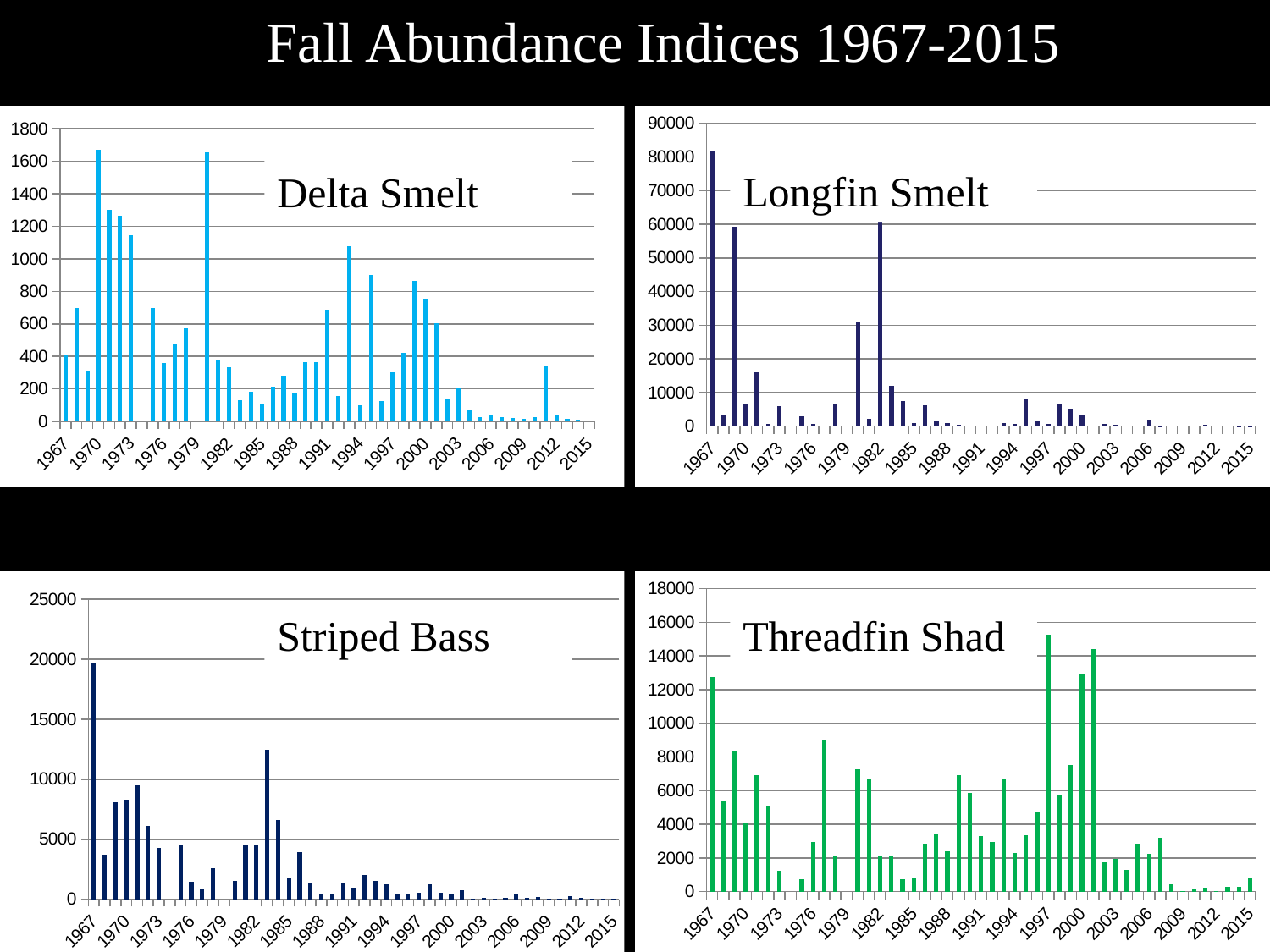
In the Delta Smelt chart, is the value for 1993 greater or less than 1000? greater In the Longfin Smelt chart, which year has the highest value? 1967 In the Striped Bass chart, is the value for 1967 greater or less than 15000? greater What is the title of the slide containing the four charts? Fall Abundance Indices 1967-2015 In the Longfin Smelt chart, is the value for 1967 greater or less than 70000? greater In the Longfin Smelt chart, which is larger, the value for 1967 or the value for 1982? 1967 In the Striped Bass chart, do the values generally rise or fall from 1967 to 2015? fall What kind of chart is the Delta Smelt chart? bar chart In the Striped Bass chart, which year has the highest value? 1967 In the Striped Bass chart, which is larger, the value for 1967 or the value for 1983? 1967 How many charts are shown on the slide? 4